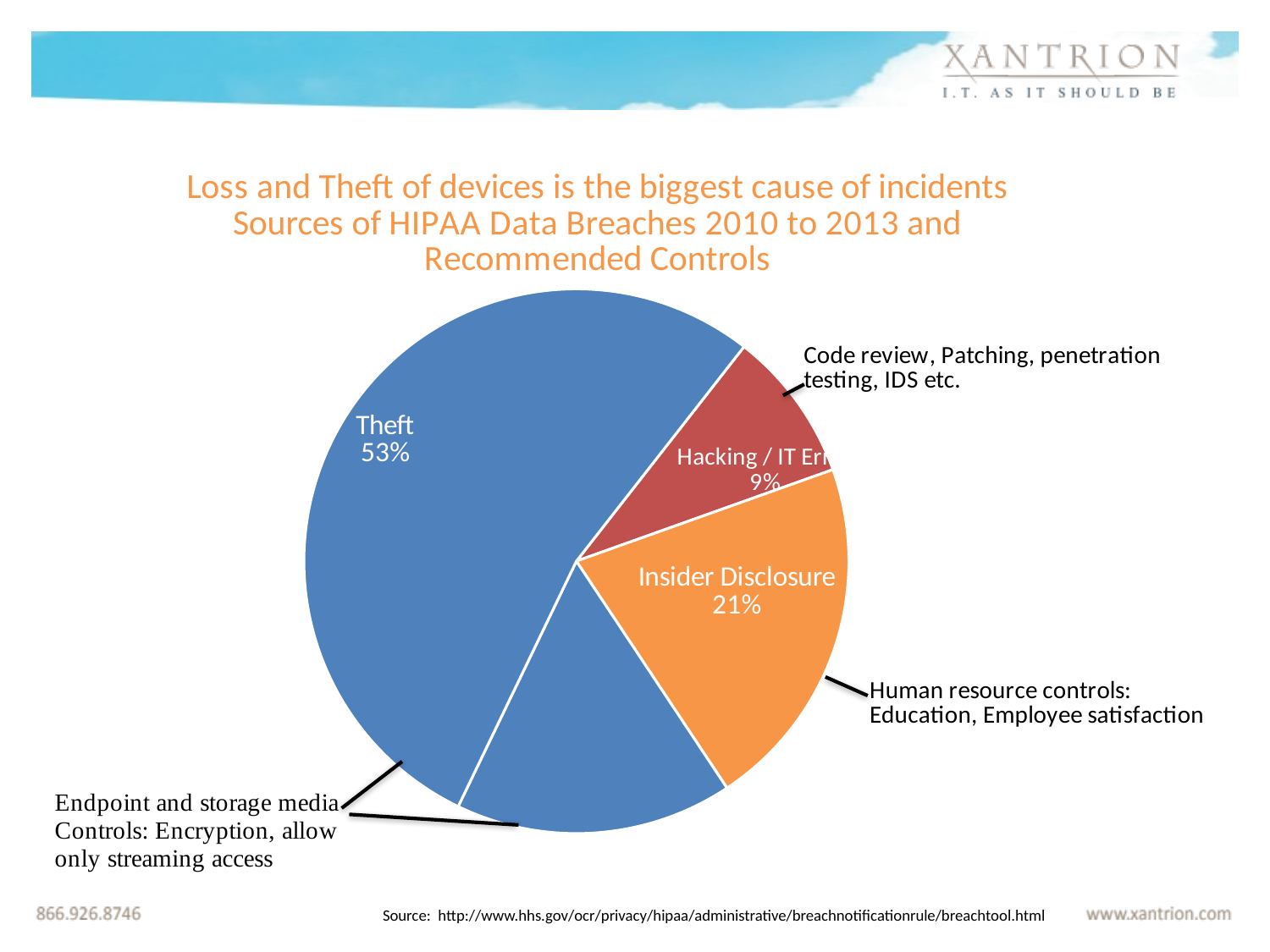
Which is larger, the Insider Disclosure share or the Hacking share? Insider Disclosure What recommended control is annotated next to the Insider Disclosure slice? Human resource controls: Education, Employee satisfaction What kind of chart is shown on the slide? pie chart Which source accounts for the largest share of breaches? Theft How many percentage points larger is the Theft share than the Insider Disclosure share? 32 percentage points What colour is the Insider Disclosure slice? orange How many slices does the pie chart have? 4 How many percentage points larger is the Insider Disclosure share than the Hacking share? 12 percentage points What percentage of breaches is attributed to the Hacking slice? 9% Which labelled source accounts for the smallest share of breaches? Hacking What percentage of HIPAA data breaches is attributed to Theft? 53% What percentage of breaches is attributed to Insider Disclosure? 21%